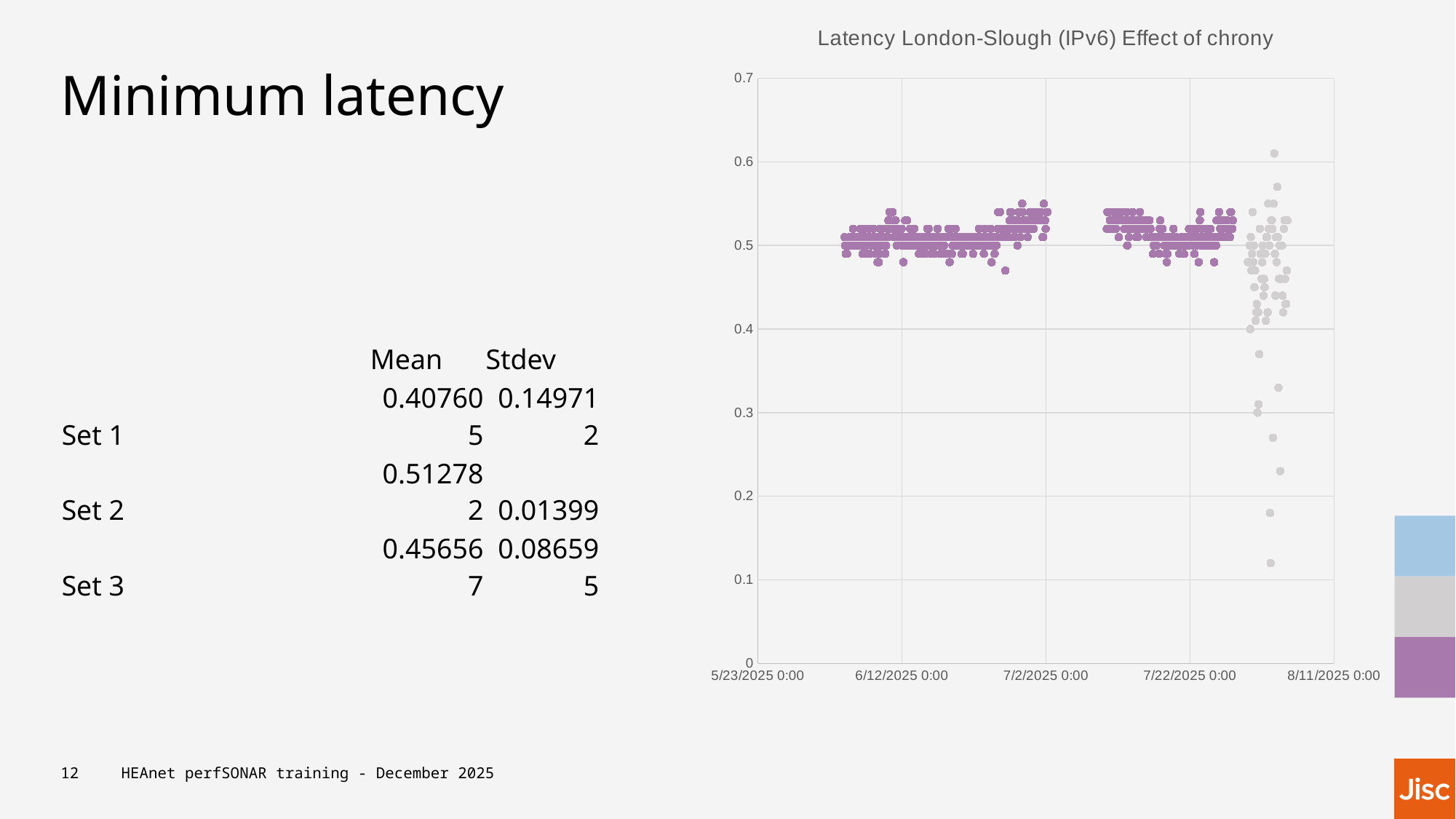
How many date labels are shown on the x axis of the chart? 5 What two colours are used for the points in the chart? purple and grey Are the purple points in the chart greater or less than 0.6? less Are the purple points in the chart greater or less than 0.4? greater Is the highest point in the chart greater or less than 0.7? less What is the last date label on the x axis of the chart? 8/11/2025 0:00 What is the highest value shown on the y axis of the chart? 0.7 What kind of chart is shown on the slide? scatter chart What is the title of the chart? Latency London-Slough (IPv6) Effect of chrony What is the first date label on the x axis of the chart? 5/23/2025 0:00 Do the grey points in the chart appear before or after the purple points along the x axis? after